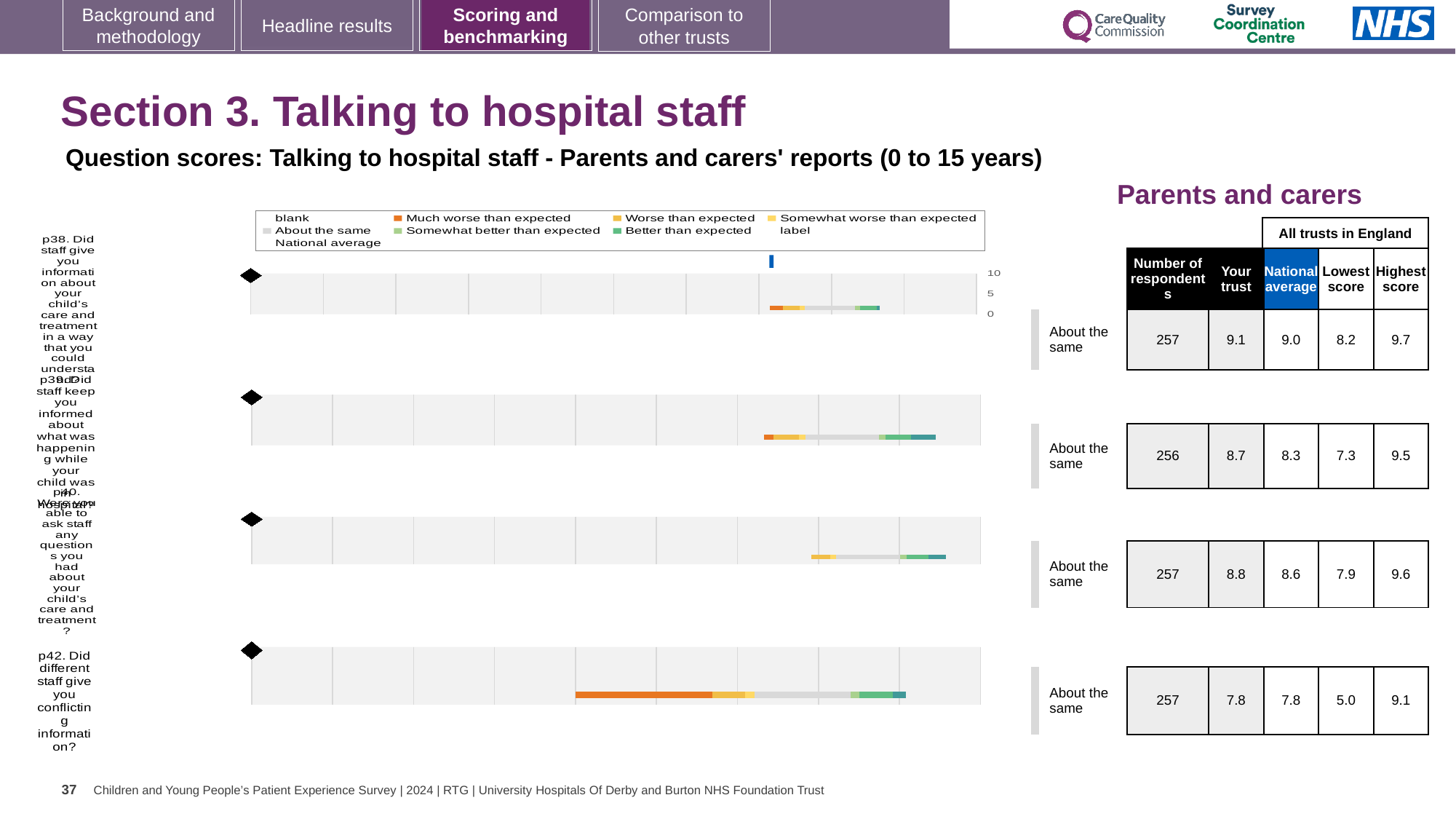
For the p38 chart (staff giving information about your child's care in a way you could understand), what is the 'Your trust' score? 9.1 For the p42 chart, what is the lowest score among all trusts in England? 5.0 Which question chart has the lowest 'Your trust' score? p42 For the p39 chart, what is the difference between the 'Your trust' score and the national average? 0.4 For the p42 chart (different staff giving conflicting information), what is the national average score? 7.8 What benchmark category label is shown next to each of the four question charts? About the same How many question charts (p38, p39, p40, p42) are shown on the slide? 4 For the p39 chart (staff keeping you informed about what was happening), how many respondents are listed? 256 For the p38 chart, what is the highest score among all trusts in England? 9.7 For the p40 chart (being able to ask staff questions), which is larger: the 'Your trust' score or the national average? Your trust What kind of chart is used to show the question scores on this slide? bar chart Which question chart has the highest 'Your trust' score? p38